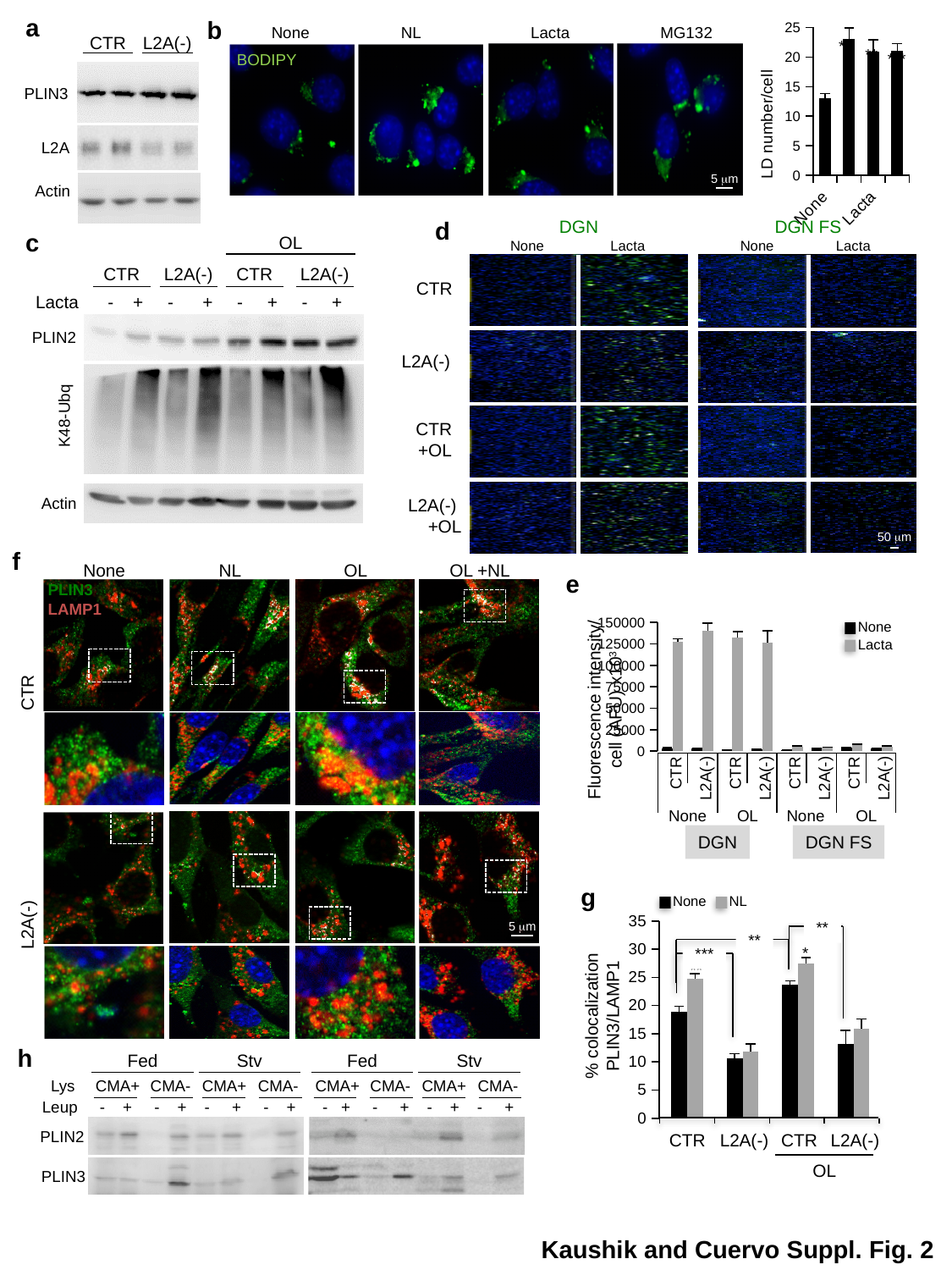
In the chart in panel g (% colocalization PLIN3/LAMP1), which category has the highest NL value? CTR under OL In the chart in panel g (% colocalization PLIN3/LAMP1), how many series does the legend list? 2 In the chart in panel e (Fluorescence intensity/cell), is the Lacta value for CTR under DGN FS (None) greater or less than 25000? less In the chart in panel b (LD number/cell), is the value for Lacta greater or less than 15? greater In the chart in panel e (Fluorescence intensity/cell), is the Lacta value for CTR under DGN (None) greater or less than 100000? greater In the chart in panel g (% colocalization PLIN3/LAMP1), which is larger for the None series: CTR or L2A(-) (without OL)? CTR In the chart in panel b (LD number/cell), which condition has the lowest LD number per cell? None What kind of chart is shown in panel b (LD number/cell)? bar chart In the chart in panel e (Fluorescence intensity/cell), how many series does the legend list? 2 In the chart in panel e (Fluorescence intensity/cell), what are the two legend entries? None and Lacta